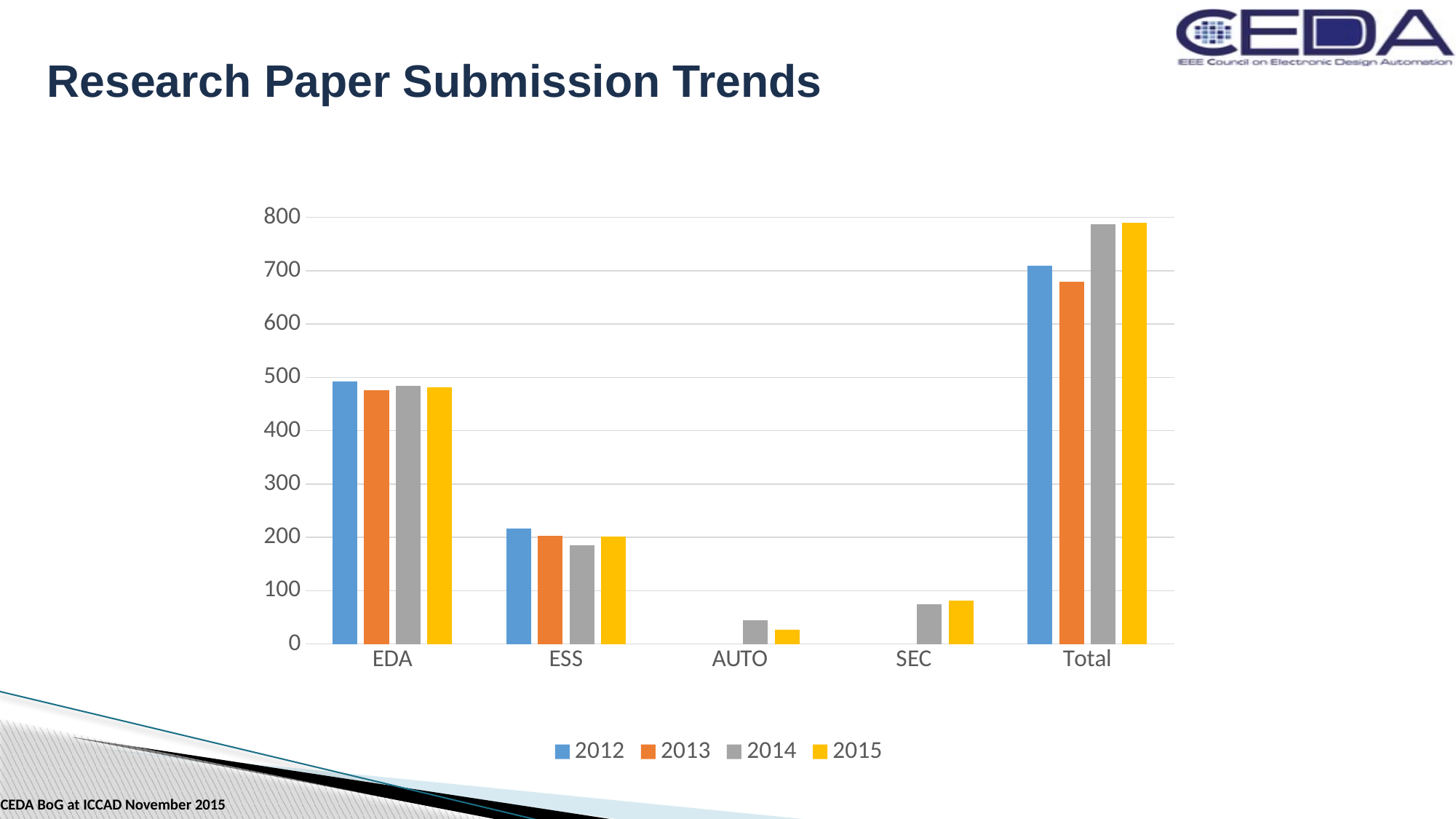
Within the Total category, which year has the lowest bar? 2013 Is the value for EDA in 2012 greater or less than 400? greater Is the value for SEC in 2015 greater or less than 100? less Is the value for Total in 2014 greater or less than 700? greater How many series does the legend list? 4 How many categories are shown on the x axis? 5 Which colour represents 2015 in the legend? yellow What kind of chart is shown on the slide? bar chart Which is larger, the Total value for 2012 or for 2013? 2012 Which category has the tallest bars? Total